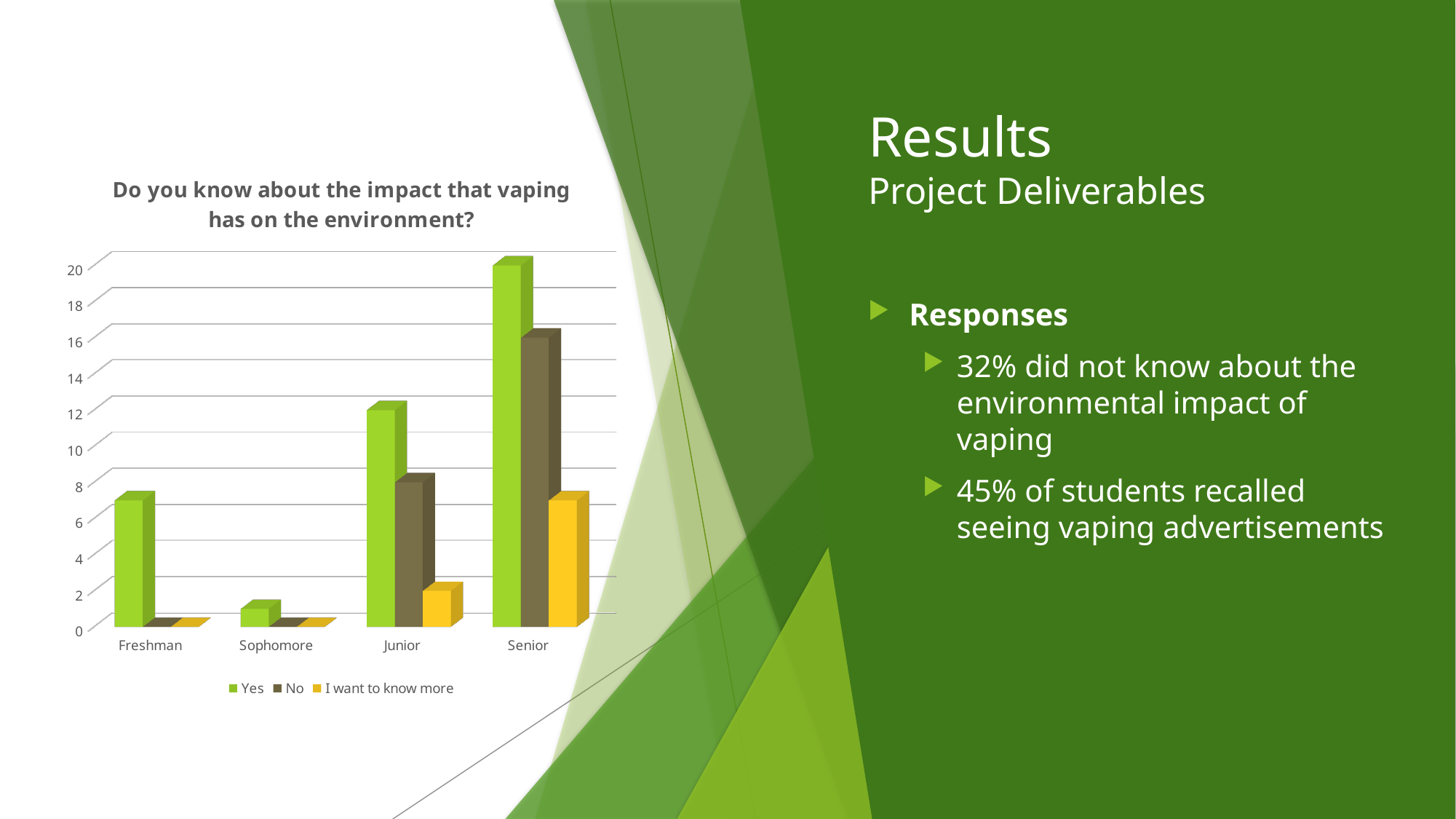
Which series is shown in yellow in the chart legend? I want to know more How many categories are shown on the x axis of the chart? 4 Is the value for Yes in the Senior category greater or less than 18? greater What kind of chart is shown on the slide? bar chart What is the title of the chart? Do you know about the impact that vaping has on the environment? Which category has the lowest value for the Yes series? Sophomore Which is larger in the Senior category, the Yes value or the No value? Yes Which category has the highest value for the Yes series? Senior Which is larger, the Yes value for Junior or the Yes value for Freshman? Junior How many series does the chart legend list? 3 Is the value for No in the Junior category greater or less than 10? less Is the value for Yes in the Freshman category greater or less than 4? greater